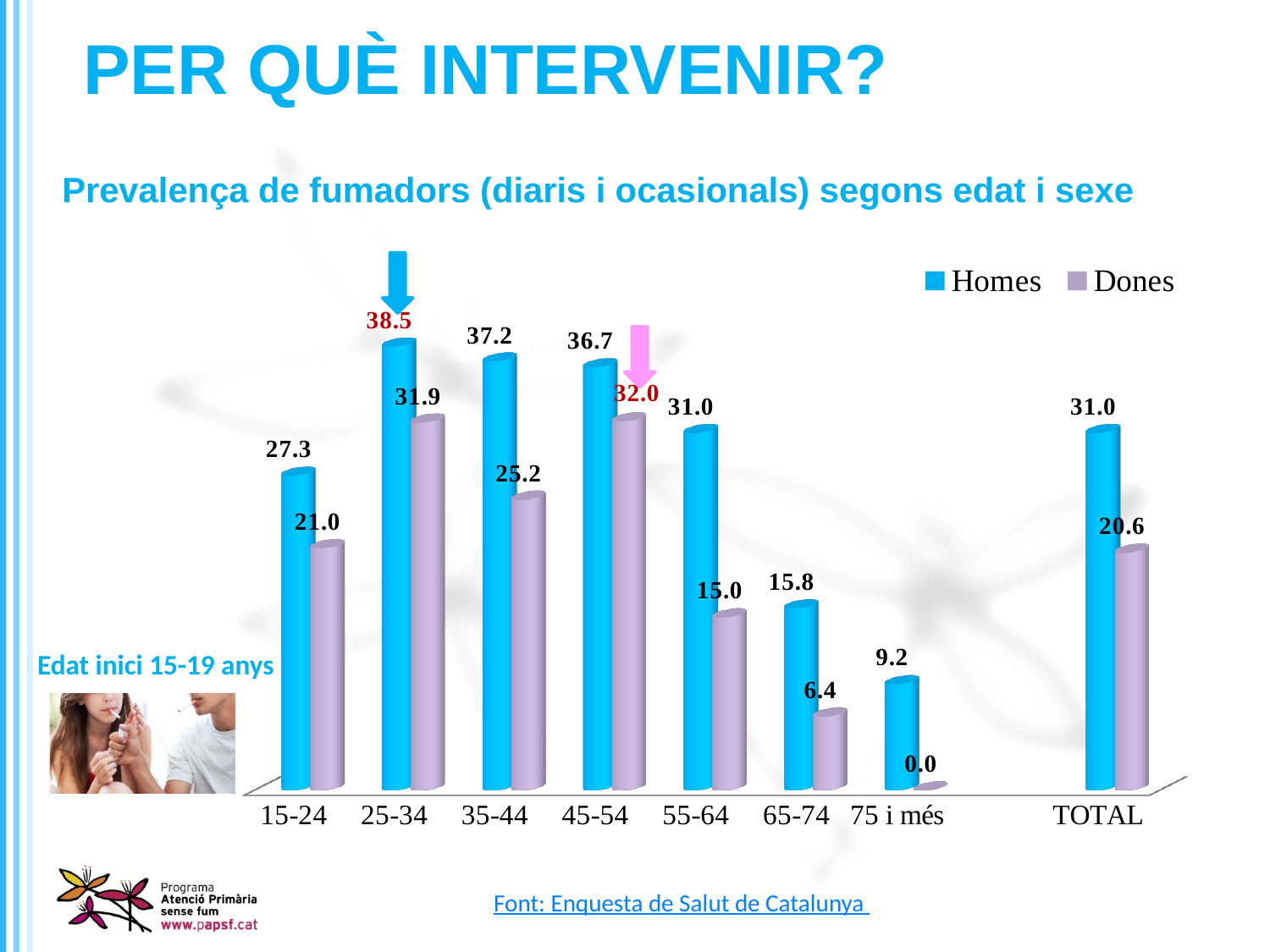
What is the value for Dones in the TOTAL category? 20.6 What is the difference between Homes and Dones in the 15-24 age group? 6.3 Which age group has the lowest value for Dones? 75 i més What kind of chart is shown on the slide? Bar chart What is the value for Homes in the 25-34 age group? 38.5 What is the title of the chart? Prevalença de fumadors (diaris i ocasionals) segons edat i sexe Which is larger in the 45-54 age group, Homes or Dones? Homes Do the Homes values rise or fall from the 25-34 age group to the 75 i més age group? Fall How many series does the legend list? 2 How many age categories (including TOTAL) are shown on the x axis? 8 What is the value for Dones in the 45-54 age group? 32.0 Which age group has the highest value for Homes? 25-34